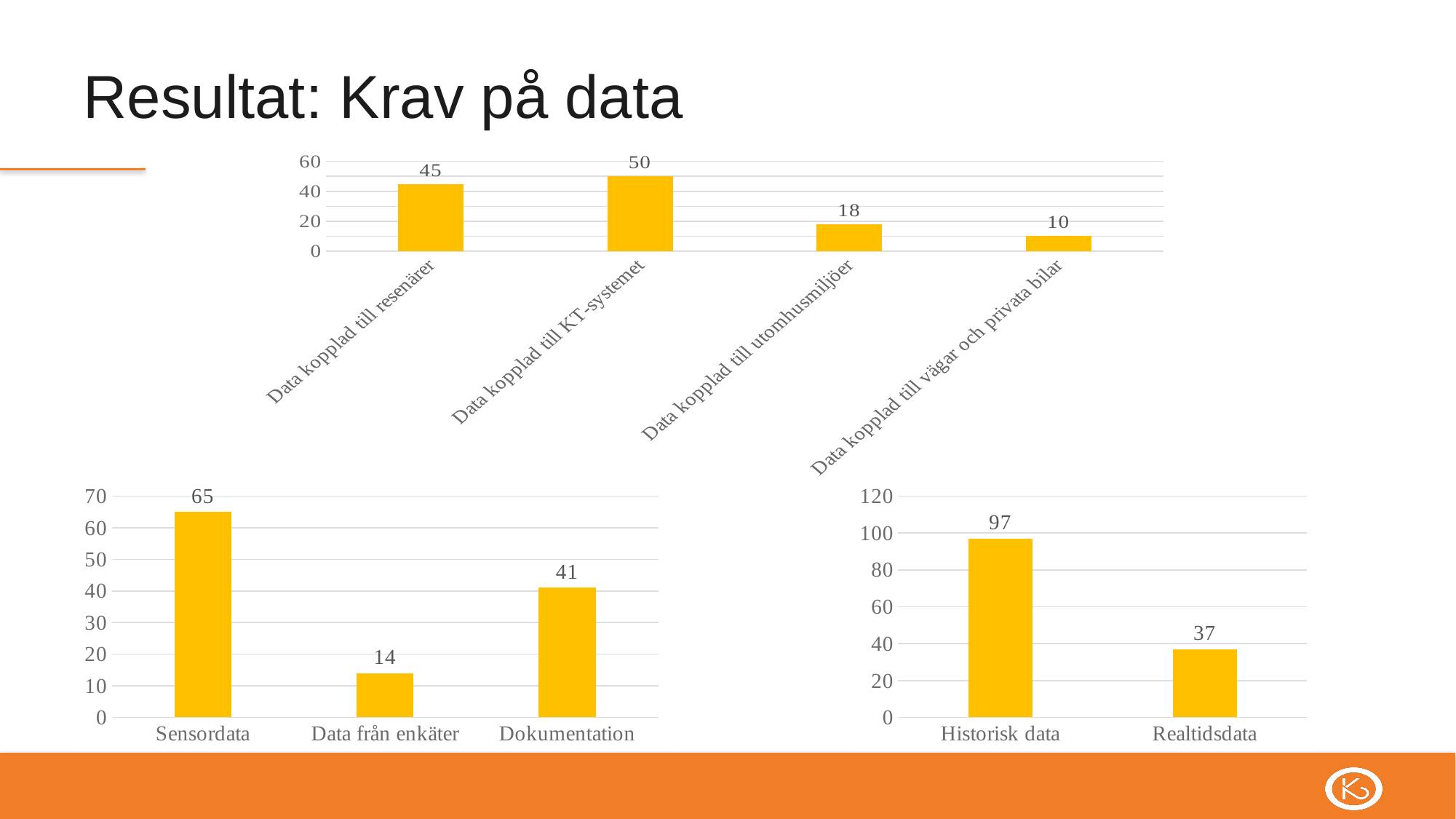
What type of chart is the bottom-right chart? Bar chart In the bottom-right chart, what is the difference between Historisk data and Realtidsdata? 60 In the bottom-right chart, what is the value for Historisk data? 97 In the bottom-left chart, what is the difference between Sensordata and Dokumentation? 24 In the top chart, what is the difference between Data kopplad till resenärer and Data kopplad till utomhusmiljöer? 27 In the top chart, what is the value for Data kopplad till KT-systemet? 50 In the bottom-left chart, what is the value for Data från enkäter? 14 In the top chart, how many categories are shown? 4 In the top chart, which category has the lowest value? Data kopplad till vägar och privata bilar In the bottom-left chart, which category has the highest value? Sensordata In the bottom-left chart, which is larger, Dokumentation or Data från enkäter? Dokumentation How many charts are on the slide? 3